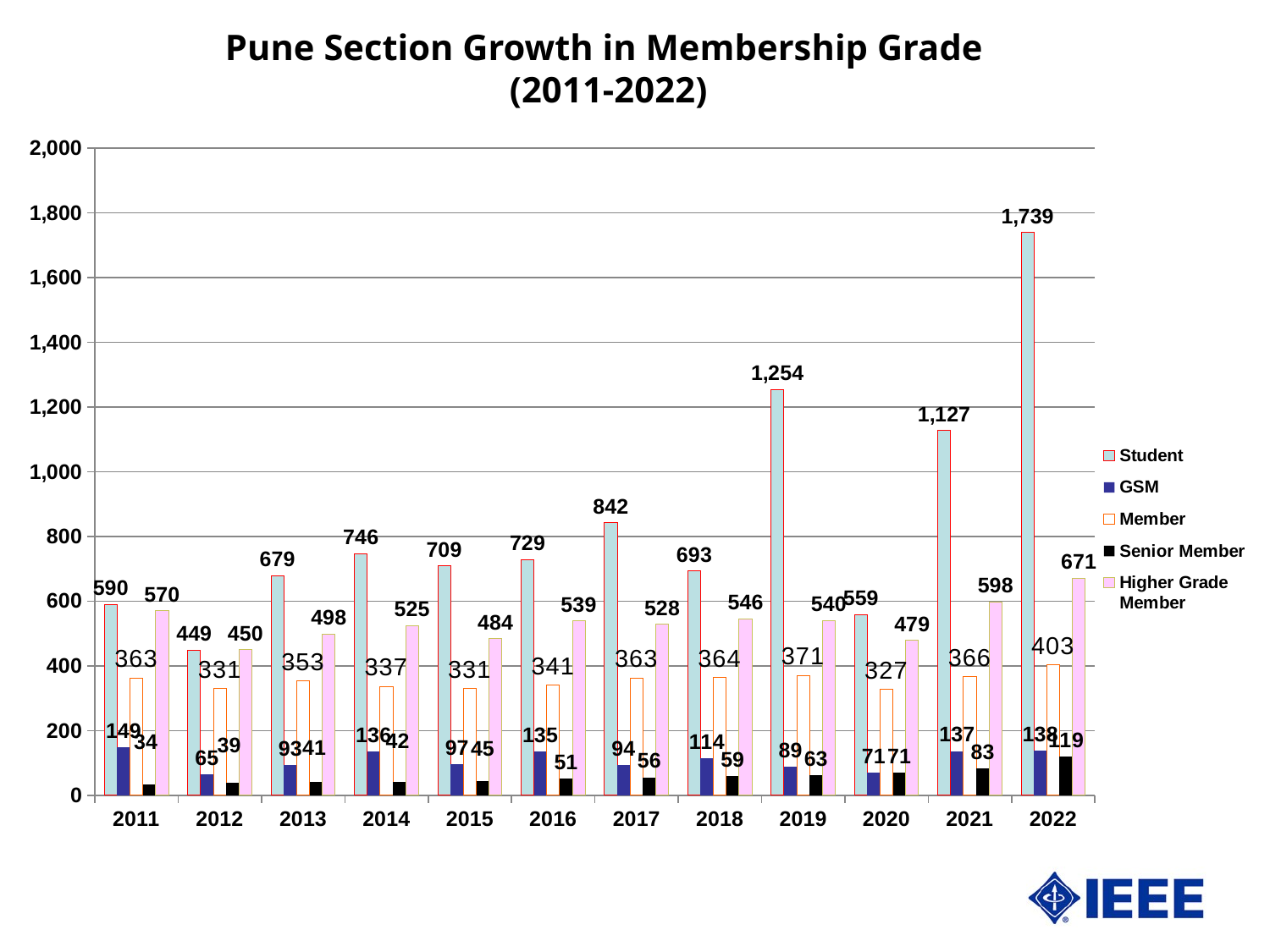
How many series does the legend list? 5 Do the Senior Member values generally rise or fall from 2011 to 2022? rise In which year is the Senior Member value lowest? 2011 What is the difference between the Student values for 2019 and 2021? 127 What is the Higher Grade Member value for 2013? 498 In which year is the Student value highest? 2022 How many years are shown along the x axis? 12 What is the title of the chart? Pune Section Growth in Membership Grade (2011-2022) What is the Member value for 2019? 371 What kind of chart is shown on the slide? bar chart What is the Student value for 2022? 1,739 Which is larger: the Higher Grade Member value for 2021 or the Student value for 2020? Higher Grade Member value for 2021